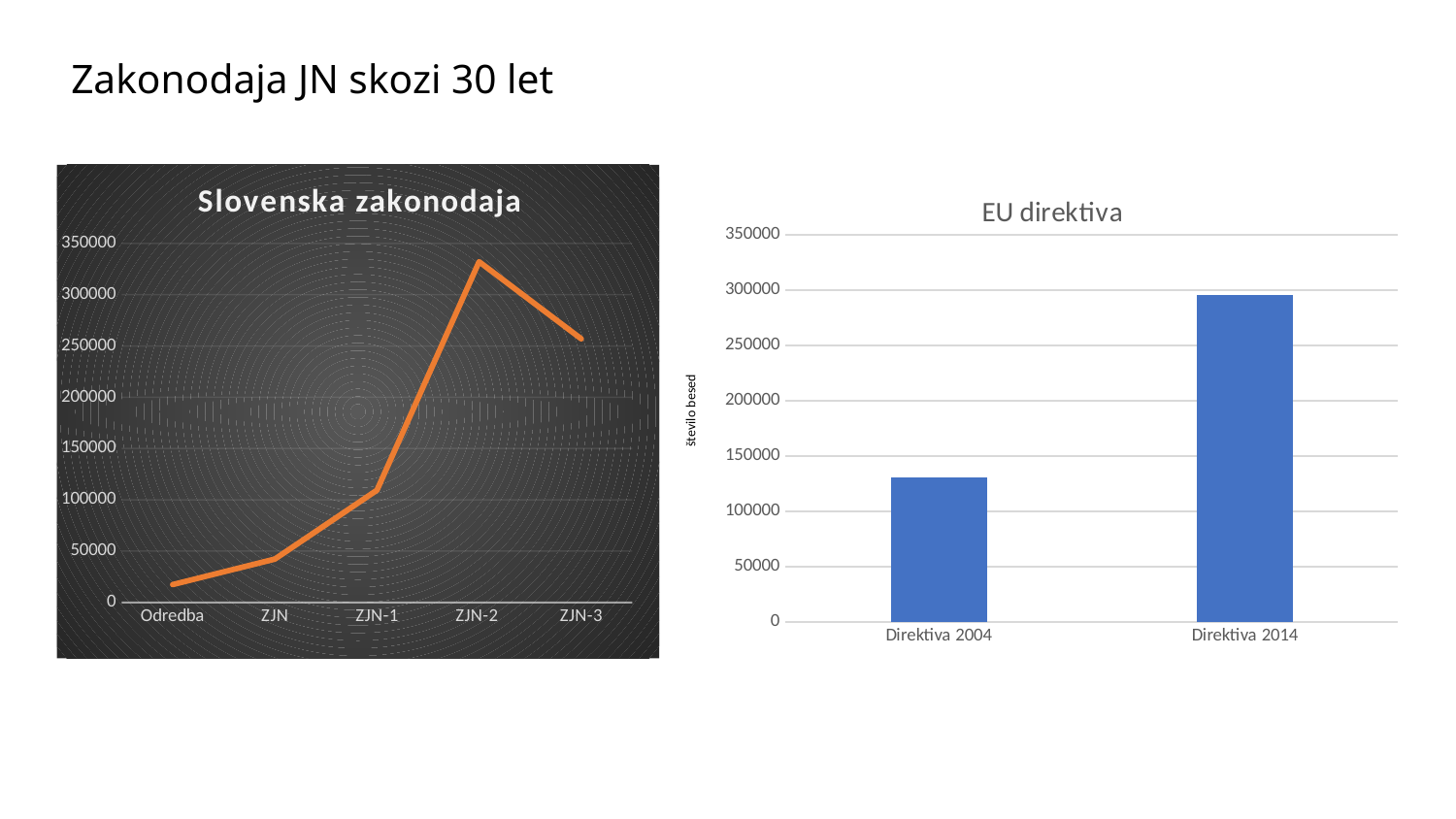
In the "Slovenska zakonodaja" chart, is the value for ZJN-2 greater or less than 300000? greater In the "Slovenska zakonodaja" chart, which category has the lowest value? Odredba In the "EU direktiva" chart, which bar is taller, Direktiva 2004 or Direktiva 2014? Direktiva 2014 In the "EU direktiva" chart, is the value for Direktiva 2014 greater or less than 250000? greater In the "EU direktiva" chart, is the value for Direktiva 2004 greater or less than 150000? less In the "Slovenska zakonodaja" chart, does the line rise or fall between ZJN-2 and ZJN-3? fall How many categories are shown on the x axis of the "Slovenska zakonodaja" chart? 5 What kind of chart is the "EU direktiva" chart? bar chart What kind of chart is the "Slovenska zakonodaja" chart? line chart In the "Slovenska zakonodaja" chart, which category has the highest value? ZJN-2 What is the label on the vertical axis of the "EU direktiva" chart? število besed How many bars are in the "EU direktiva" chart? 2